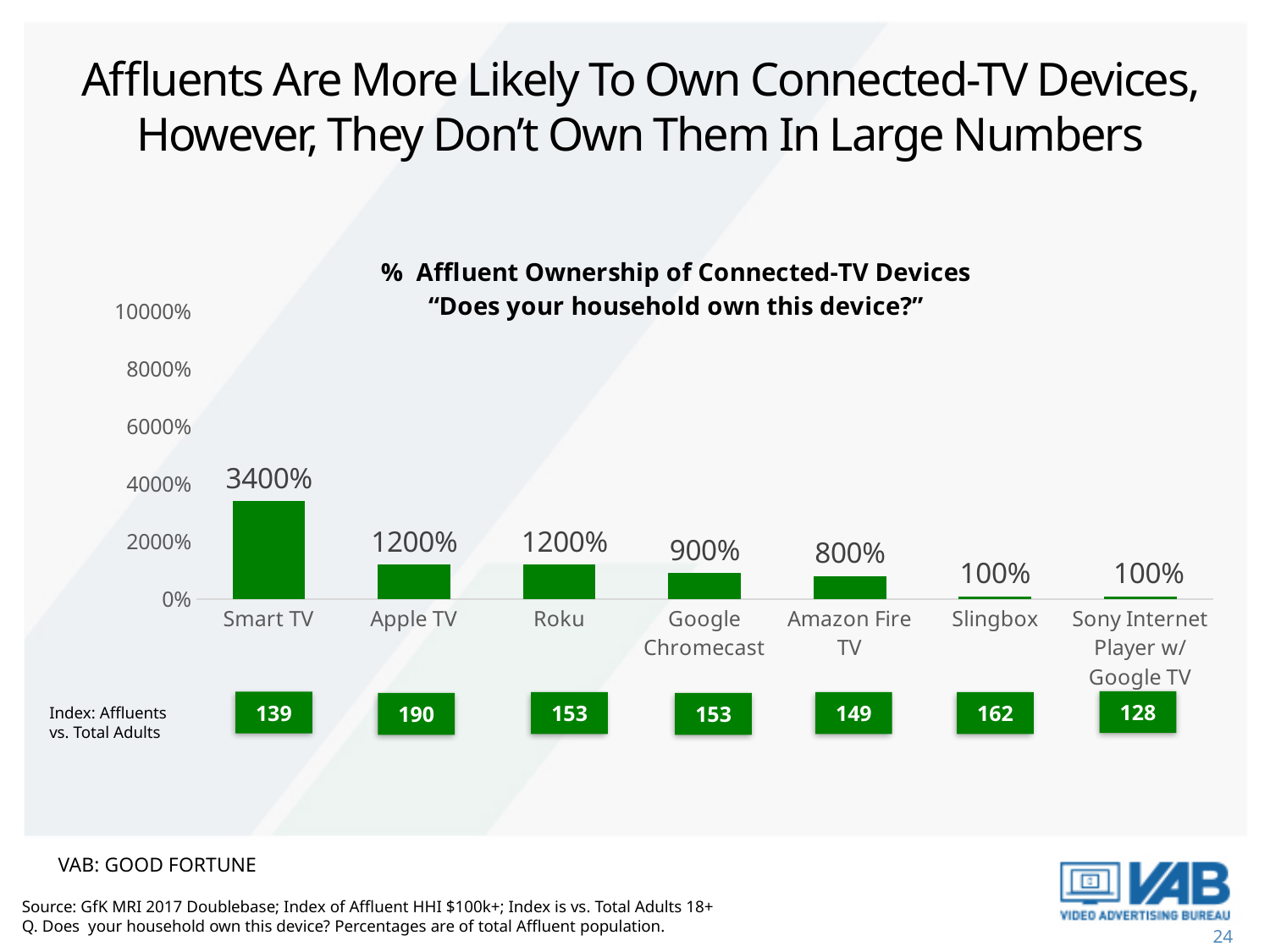
What is the difference between the values for Smart TV and Apple TV? 2200% Is the value for Smart TV greater or less than 4000%? less What is the index value (Affluents vs. Total Adults) shown below Apple TV? 190 What is the value for Smart TV? 3400% How many devices are shown on the x axis? 7 What is the difference between the values for Google Chromecast and Amazon Fire TV? 100% Do the values rise or fall from left to right along the x axis? fall What is the value for Amazon Fire TV? 800% What is the value for Google Chromecast? 900% Which is larger, the value for Roku or the value for Google Chromecast? Roku Which device has the highest value? Smart TV What kind of chart is shown? bar chart